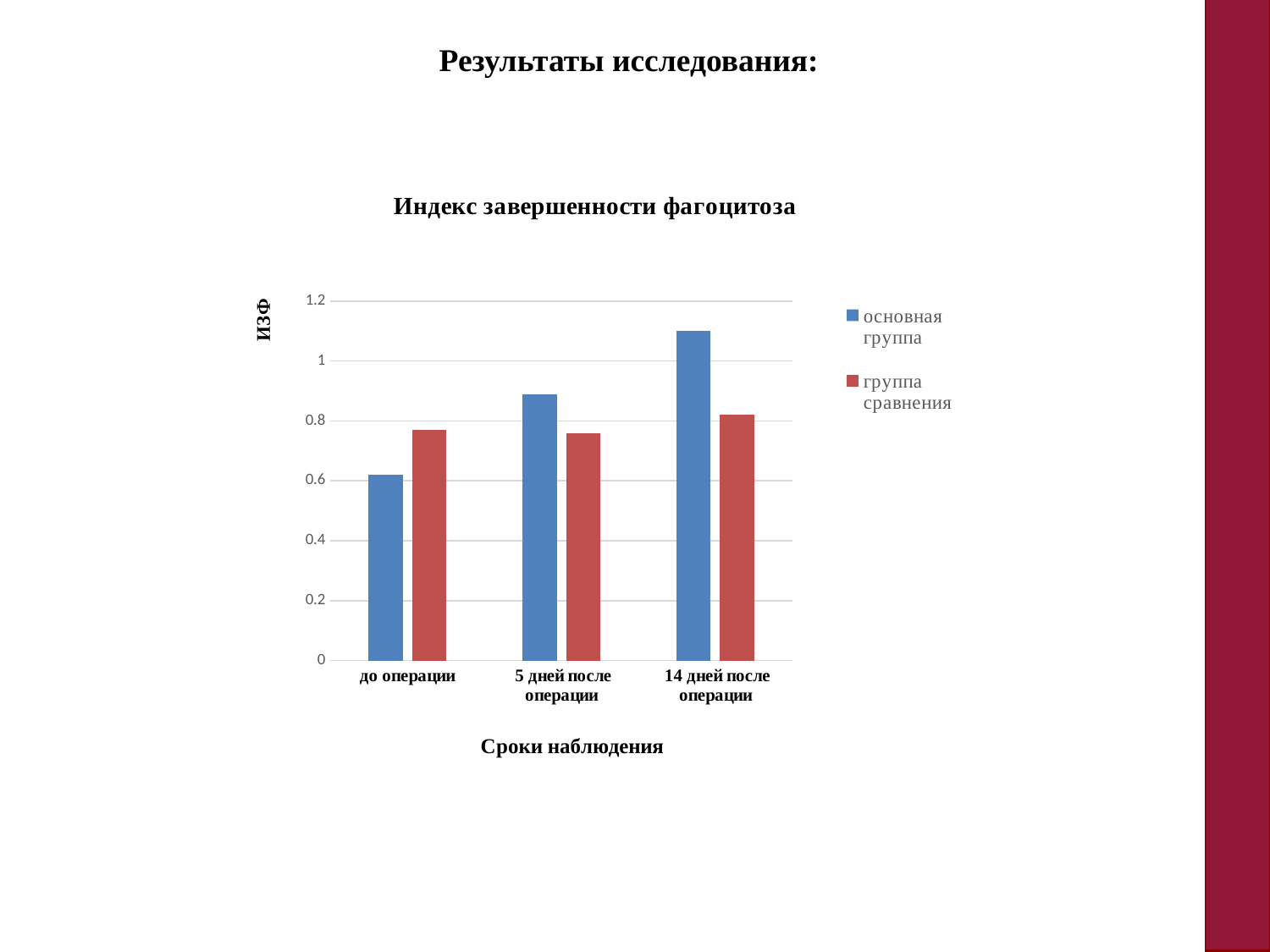
What kind of chart is shown on the slide? bar chart Is the value for основная группа at 14 дней после операции greater or less than 1? greater Do the values for основная группа rise or fall from до операции to 14 дней после операции? rise At which observation period is the value for основная группа lowest? до операции Is the value for группа сравнения at до операции greater or less than 0.8? less At which observation period is the value for основная группа highest? 14 дней после операции How many series does the legend list? 2 At 14 дней после операции, which group has the larger value: основная группа or группа сравнения? основная группа How many observation periods (categories) are shown on the x axis? 3 At до операции, which group has the larger value: основная группа or группа сравнения? группа сравнения Is the value for основная группа at 5 дней после операции greater or less than 0.8? greater What is the title of the chart? Индекс завершенности фагоцитоза